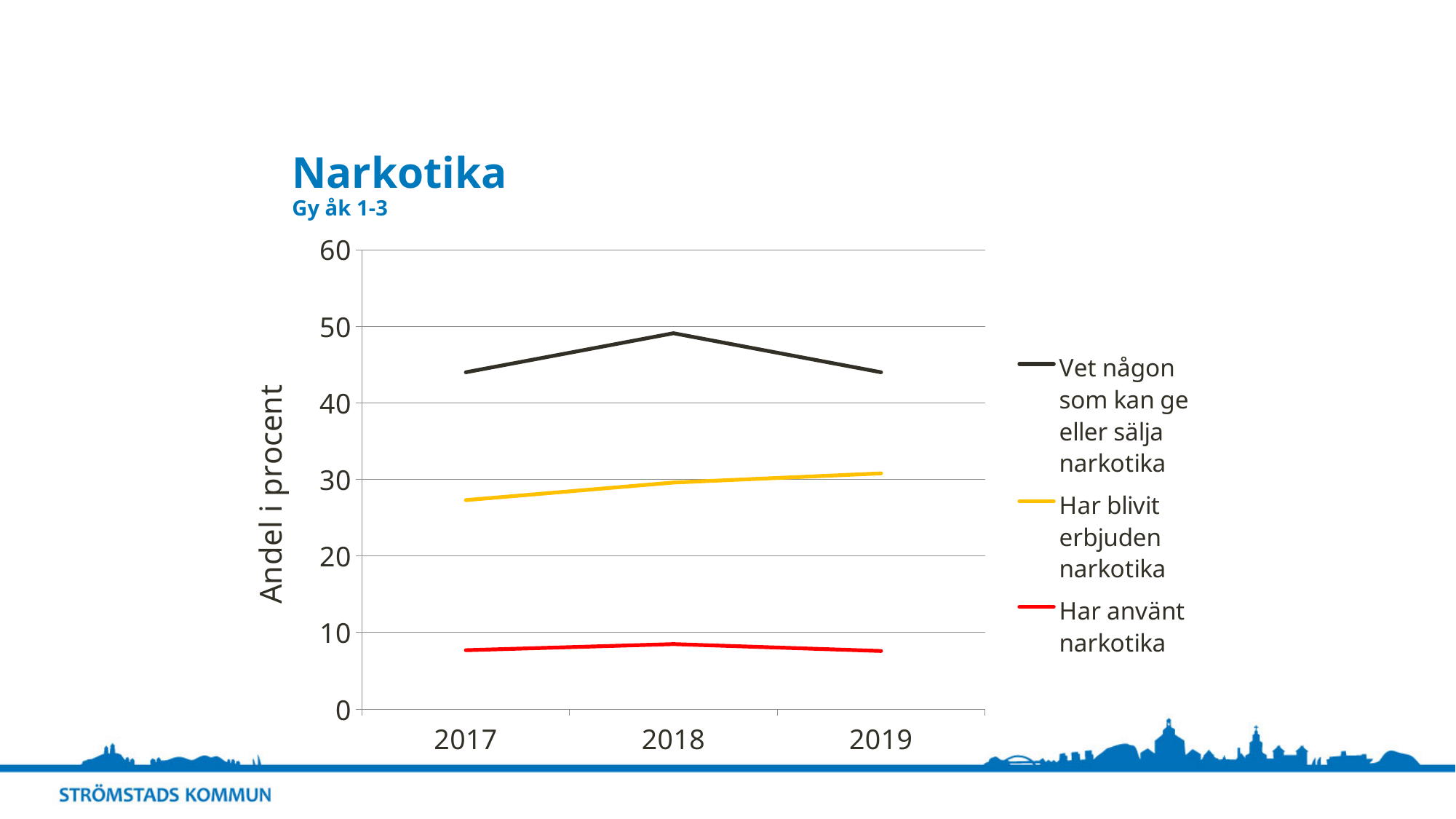
How many series does the legend list? 3 What kind of chart is shown on the slide? line chart Is the value for 'Vet någon som kan ge eller sälja narkotika' in 2018 greater or less than 40? greater How many years are shown on the x axis? 3 Is the value for 'Har använt narkotika' in 2019 greater or less than 10? less In which year does the series 'Vet någon som kan ge eller sälja narkotika' reach its highest value? 2018 Which series has the highest values across all years? Vet någon som kan ge eller sälja narkotika Which series has the lowest values across all years? Har använt narkotika Which is larger in 2017: the value for 'Har blivit erbjuden narkotika' or the value for 'Har använt narkotika'? Har blivit erbjuden narkotika What is the title of the y axis? Andel i procent Does the series 'Har blivit erbjuden narkotika' rise or fall from 2017 to 2019? rise